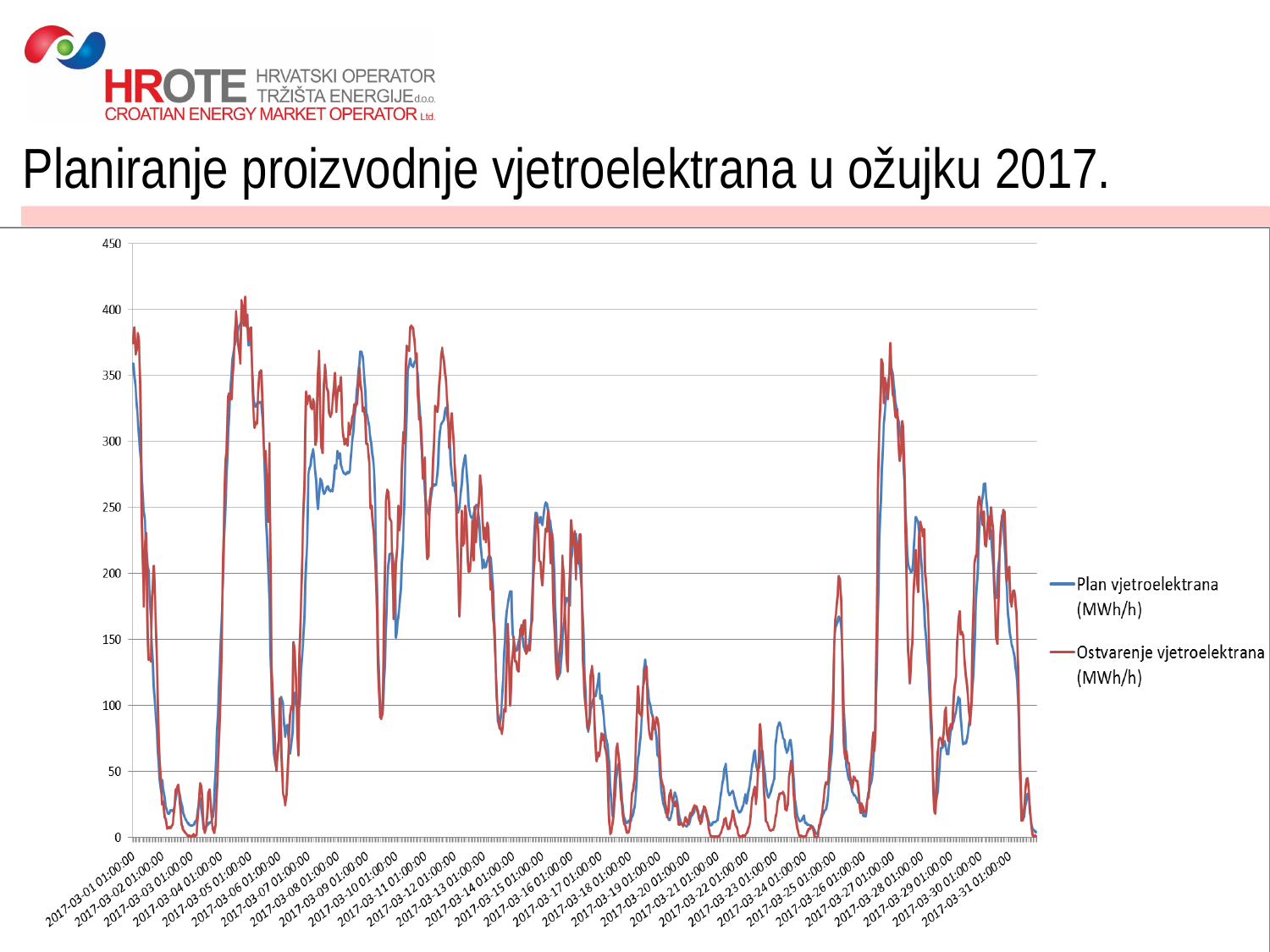
Is the value of Plan vjetroelektrana (MWh/h) at 2017-03-01 01:00:00 greater or less than 300? greater Is the peak of Ostvarenje vjetroelektrana (MWh/h) around 2017-03-27 01:00:00 greater or less than 300? greater Is the peak of Ostvarenje vjetroelektrana (MWh/h) around 2017-03-05 01:00:00 greater or less than 350? greater Does the Plan vjetroelektrana (MWh/h) series end at 2017-03-31 higher or lower than it starts at 2017-03-01? lower Which colour is used for the Ostvarenje vjetroelektrana (MWh/h) series? red Around 2017-03-23 01:00:00, which series has the higher value, Plan vjetroelektrana or Ostvarenje vjetroelektrana? Plan vjetroelektrana How many date labels are shown along the x axis? 31 At 2017-03-01 01:00:00, which series has the higher value, Plan vjetroelektrana or Ostvarenje vjetroelektrana? Ostvarenje vjetroelektrana What are the two series named in the legend? Plan vjetroelektrana (MWh/h) and Ostvarenje vjetroelektrana (MWh/h) How many series does the legend list? 2 What kind of chart is shown on the slide? line chart